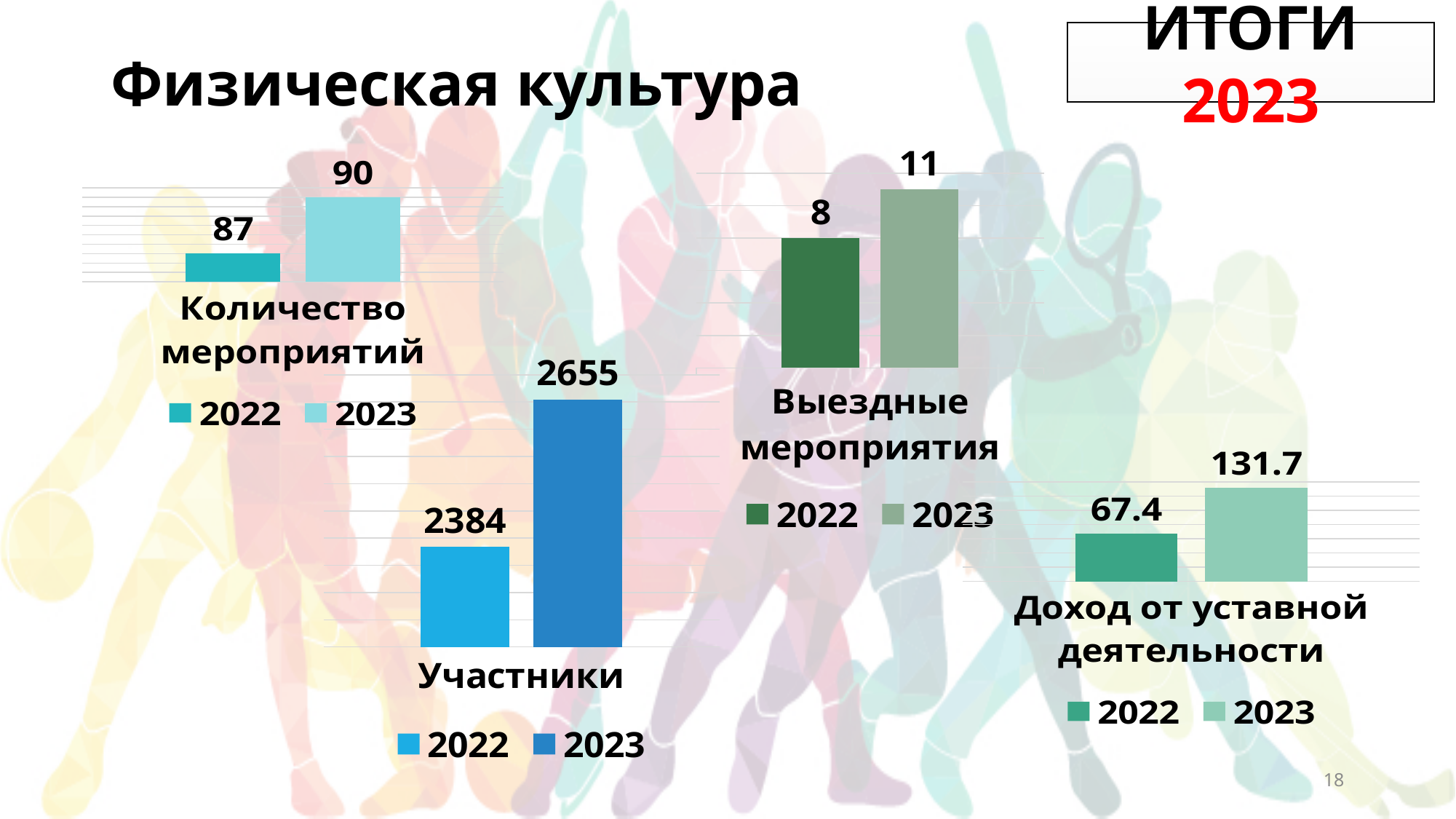
What type of chart is the 'Выездные мероприятия' chart? Bar chart In the 'Количество мероприятий' chart, what is the value for 2022? 87 How many series does the legend of the 'Участники' chart list? 2 In the 'Участники' chart, what is the difference between the 2023 and 2022 values? 271 In the 'Выездные мероприятия' chart, which year has the higher value? 2023 In the 'Доход от уставной деятельности' chart, which year has the lower value? 2022 In the 'Количество мероприятий' chart, do the values rise or fall from 2022 to 2023? Rise In the 'Выездные мероприятия' chart, what is the value for 2022? 8 In the 'Участники' chart, what is the value for 2023? 2655 In the 'Доход от уставной деятельности' chart, what is the difference between the 2023 and 2022 values? 64.3 In the 'Доход от уставной деятельности' chart, what is the value for 2023? 131.7 In the 'Количество мероприятий' chart, what is the value for 2023? 90